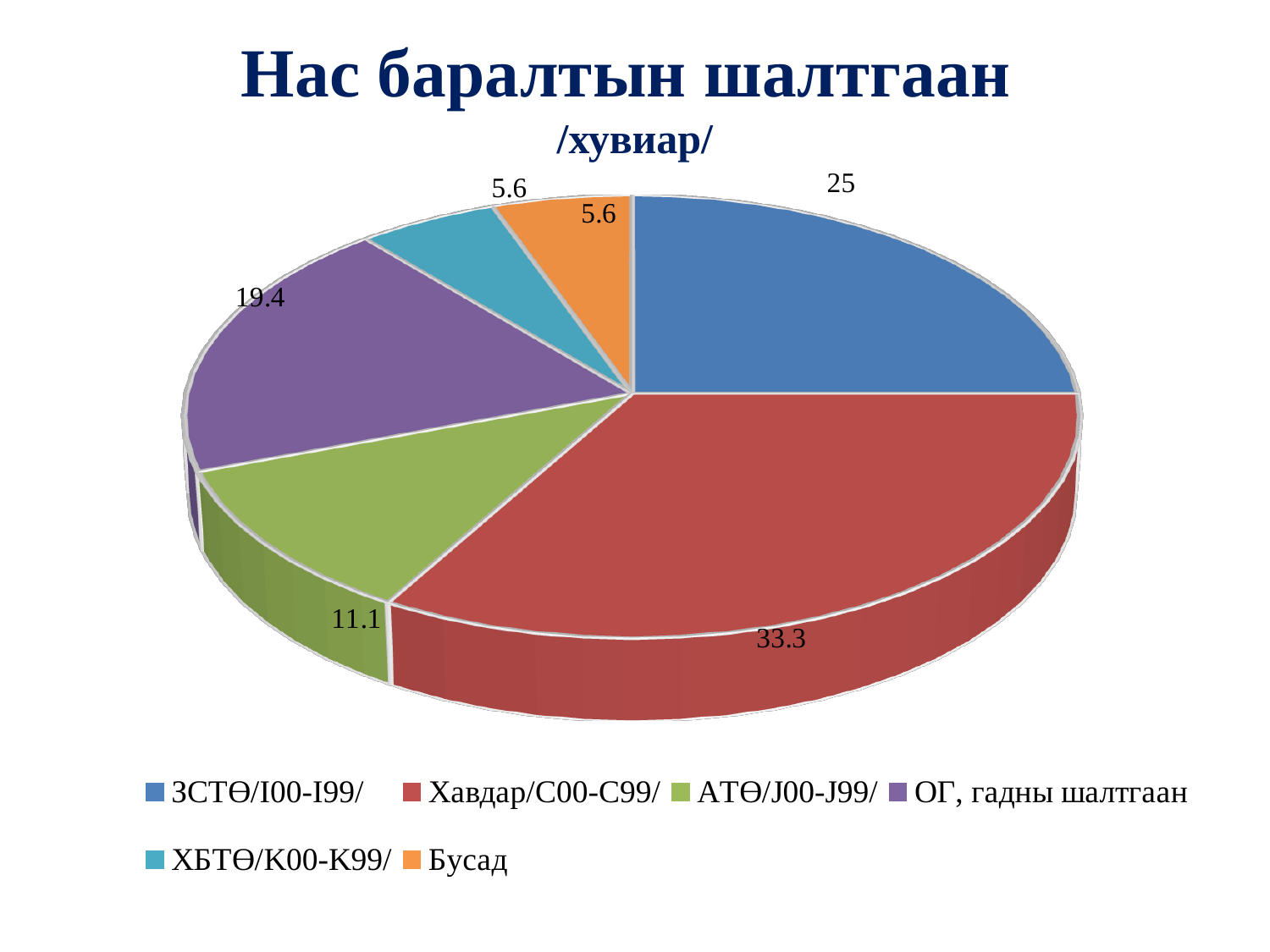
What is the value for АТӨ/J00-J99/? 11.1 What is the value for ОГ, гадны шалтгаан? 19.4 What is the value for Бусад? 5.6 Which category has the largest slice? Хавдар/C00-C99/ What is the value for Хавдар/C00-C99/? 33.3 What is the value for ЗСТӨ/I00-I99/? 25 What is the difference between the values for Хавдар/C00-C99/ and ЗСТӨ/I00-I99/? 8.3 What is the difference between the values for ЗСТӨ/I00-I99/ and ХБТӨ/K00-K99/? 19.4 How many categories does the pie chart have? 6 What is the title of the chart? Нас баралтын шалтгаан /хувиар/ Which is larger, the value for ОГ, гадны шалтгаан or the value for АТӨ/J00-J99/? ОГ, гадны шалтгаан What type of chart is shown on the slide? Pie chart